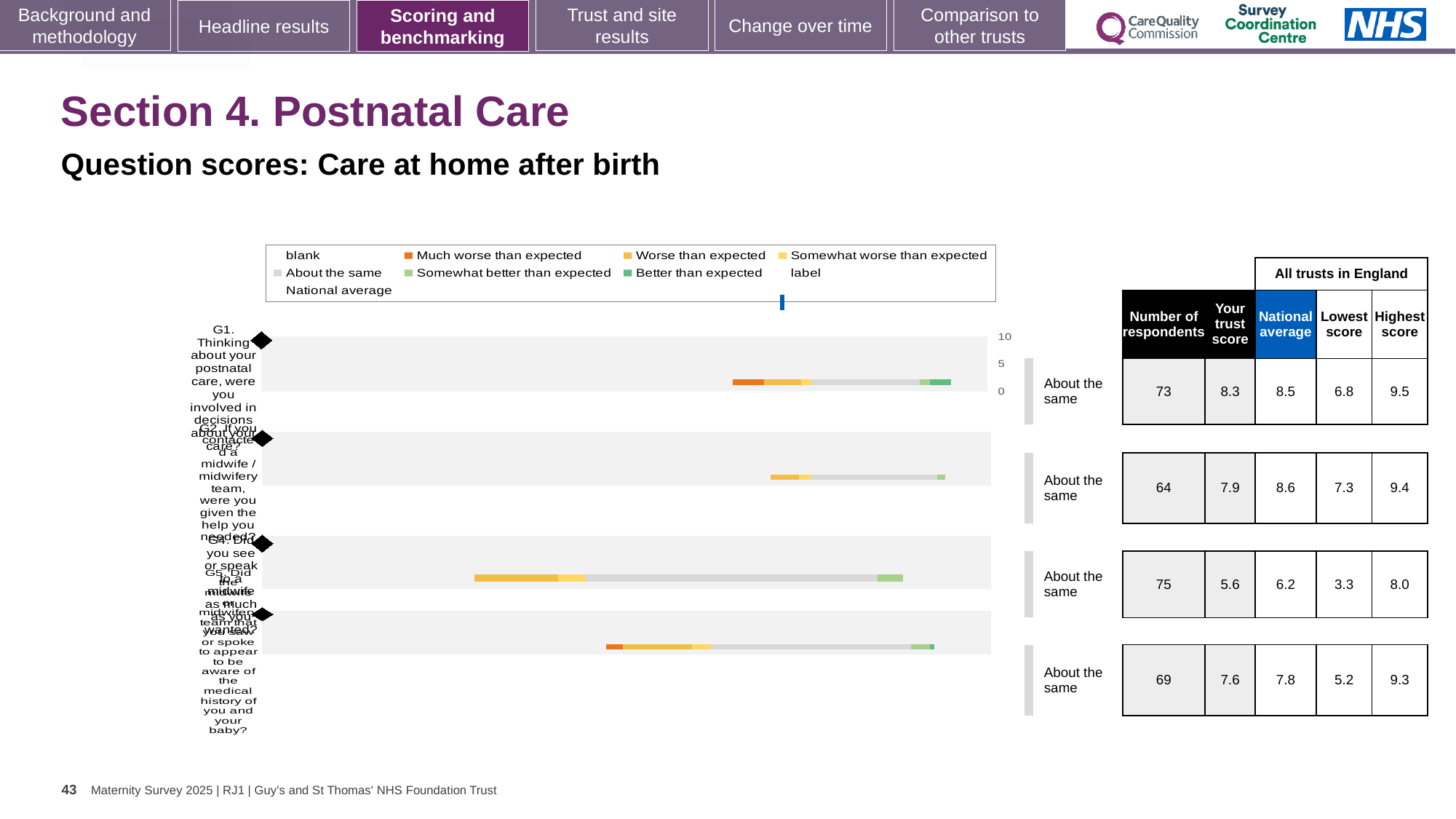
In the chart legend, what does the blue marker represent? National average In the table beside the chart, what is the highest score among all trusts in England for the second row (G2)? 9.4 In the table beside the chart, what is the lowest score among all trusts in England for the fourth row (G5)? 5.2 How many question rows (bars) does the chart show? 4 In the table beside the chart, which row has the highest number of respondents? G4 (third row), 75 In the table beside the chart, for the first row (G1), which is larger: the trust score or the national average? National average What type of chart is shown on the slide? bar chart In the table beside the chart, what is the number of respondents for the third row (G4)? 75 In the table beside the chart, what is the 'Your trust score' for the first row (G1)? 8.3 In the table beside the chart, what is the difference between the national average and the trust score for the third row (G4)? 0.6 What benchmark label is shown next to each of the four bars in the chart? About the same In the table beside the chart, which row has the lowest 'Your trust score'? G4 (third row), 5.6